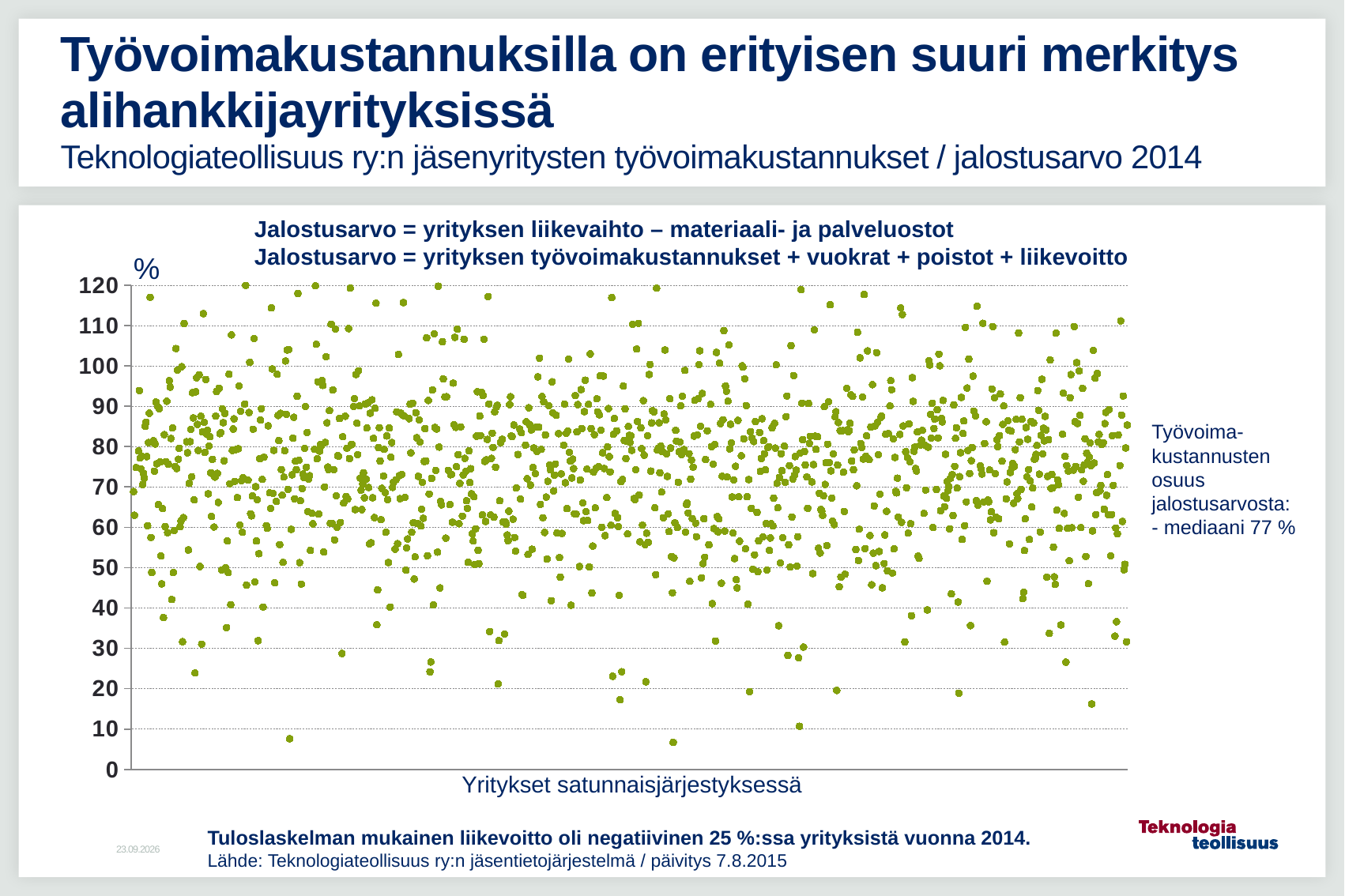
What unit is shown at the top of the y axis of the chart? % What is the label of the x axis of the chart? Yritykset satunnaisjärjestyksessä According to the annotation on the chart, what is the median share of labour costs in value added (jalostusarvo)? 77 % What kind of chart is shown on the slide? scatter chart